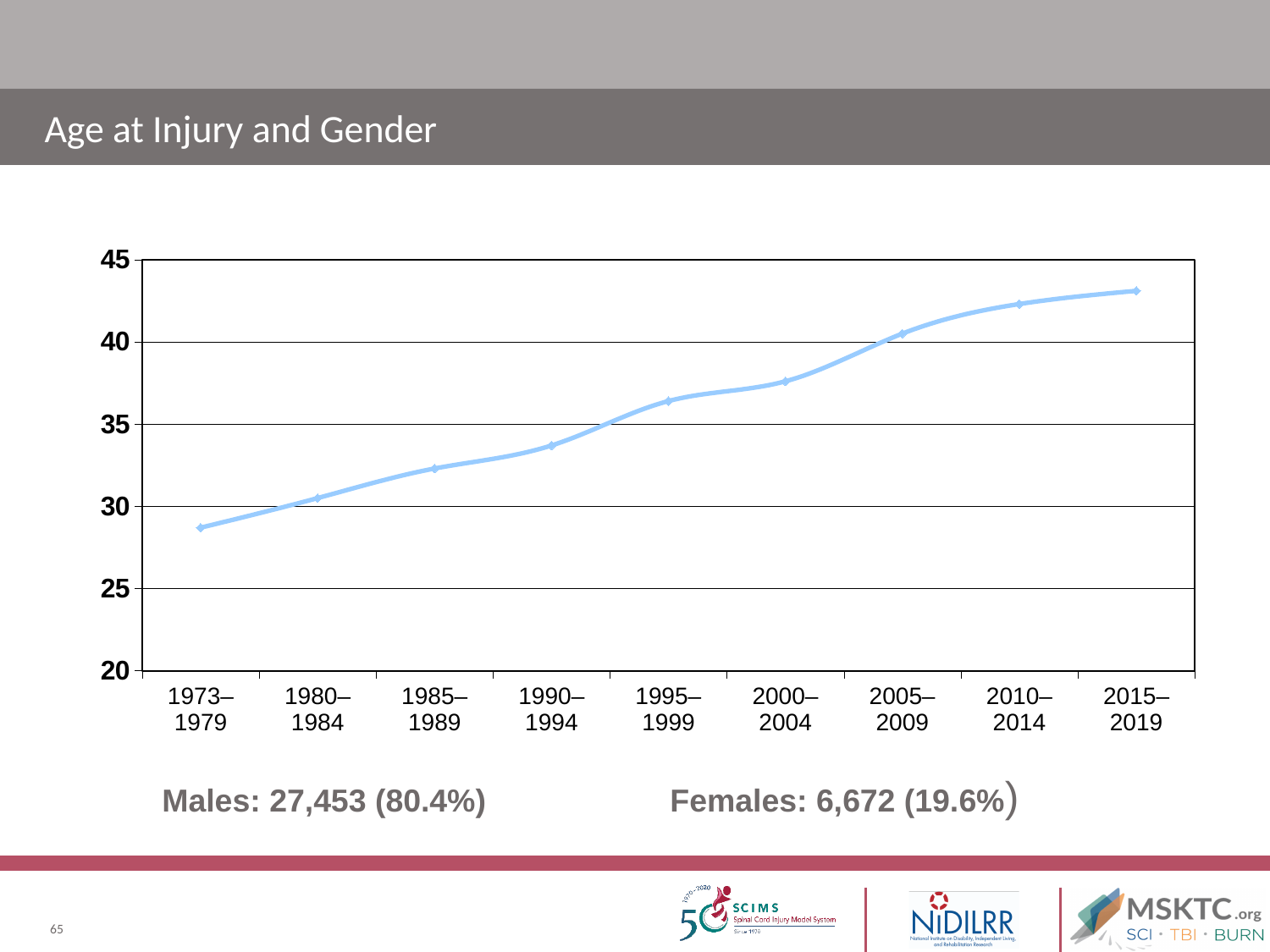
Which time period has the highest value? 2015–2019 Is the value for 2000–2004 greater or less than 40? less Is the value for 1995–1999 greater or less than 35? greater Do the values rise or fall from 1973–1979 to 2015–2019? rise Which time period has the lowest value? 1973–1979 Which is larger, the value for 2005–2009 or the value for 1995–1999? 2005–2009 What is the title of the slide containing the chart? Age at Injury and Gender How many time periods are plotted along the x axis? 9 What kind of chart is shown on the slide? line chart Is the value for 2010–2014 greater or less than 40? greater